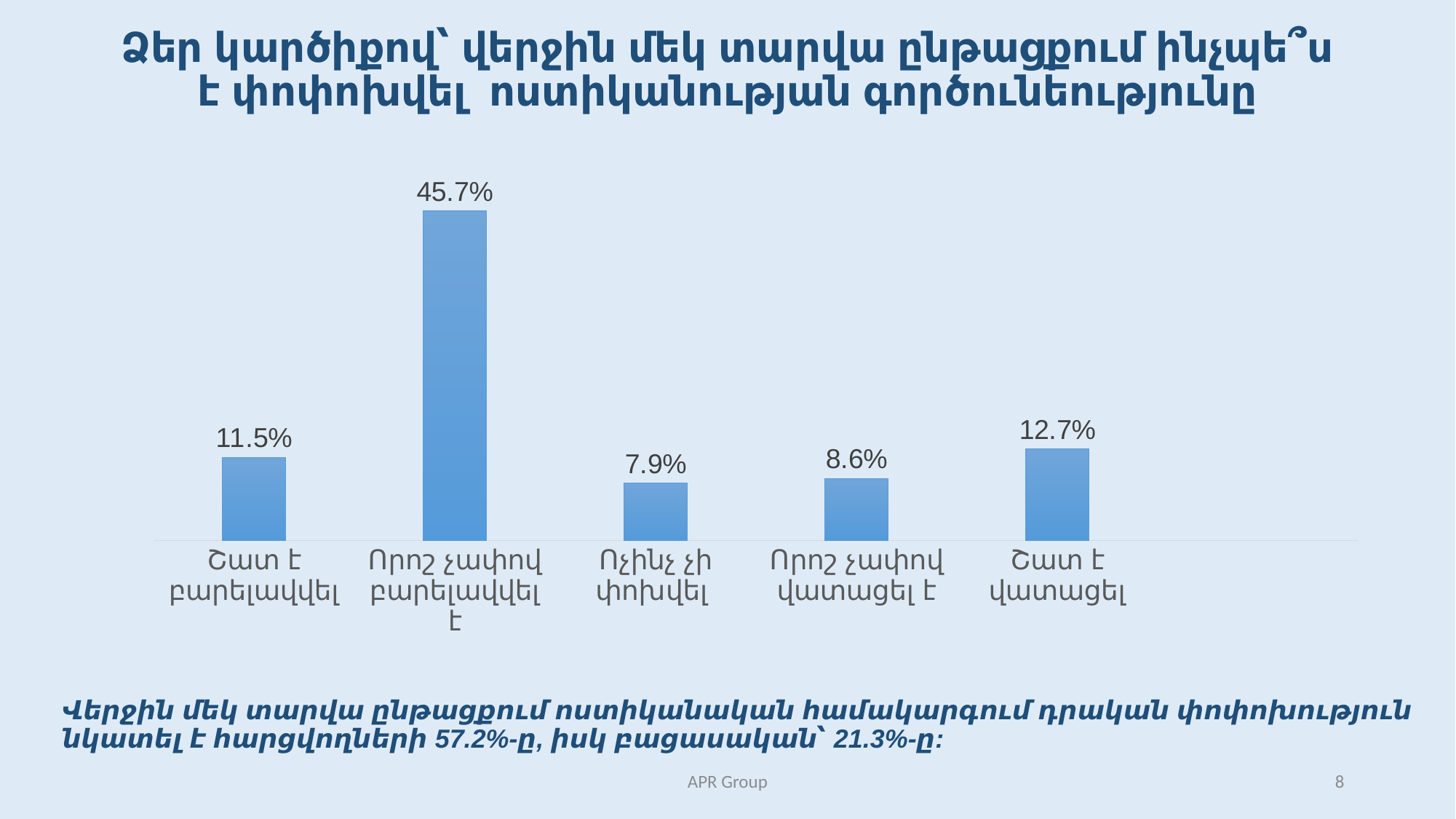
What is the difference between the values for "Որոշ չափով բարելավվել է" and "Շատ է վատացել"? 33.0% How many categories are shown in the chart? 5 What is the value for "Ոչինչ չի փոխվել"? 7.9% What is the difference between the values for "Շատ է վատացել" and "Շատ է բարելավվել"? 1.2% What is the value for "Շատ է վատացել"? 12.7% Which category has the highest value? Որոշ չափով բարելավվել է Which is larger, the value for "Շատ է վատացել" or the value for "Որոշ չափով վատացել է"? Շատ է վատացել What is the value for "Շատ է բարելավվել"? 11.5% What is the value for "Որոշ չափով վատացել է"? 8.6% Which category has the lowest value? Ոչինչ չի փոխվել What kind of chart is shown on the slide? Bar chart What is the value for "Որոշ չափով բարելավվել է"? 45.7%